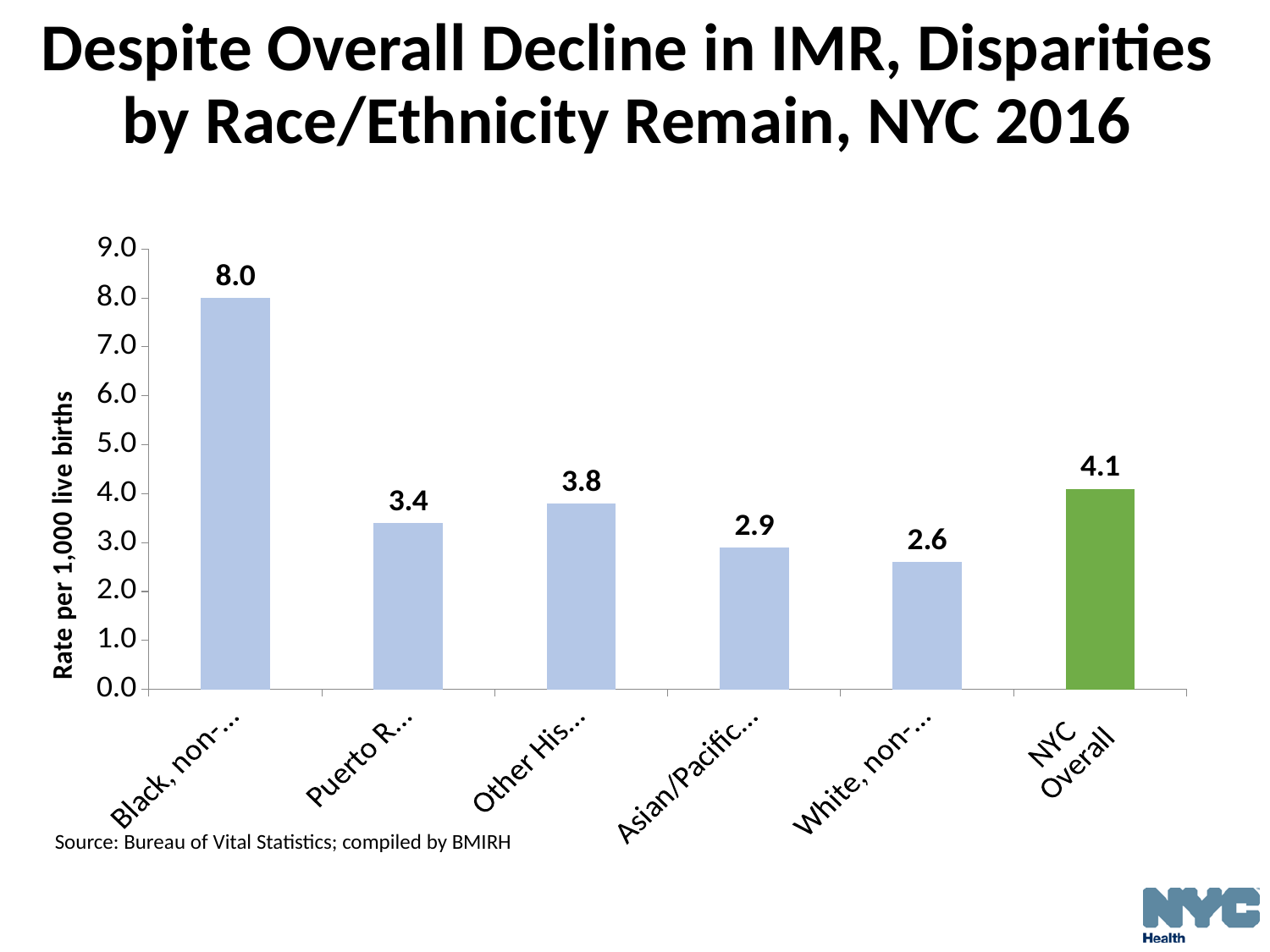
What is the value of the bar labelled "White, non-…"? 2.6 What is the value of the bar labelled "Asian/Pacific…"? 2.9 Which is larger, the value for "Puerto R…" or the value for "Other His…"? Other His… Which category has the highest rate? Black, non-… What is the label of the y-axis? Rate per 1,000 live births What type of chart is shown on the slide? Bar chart Which category has the lowest rate? White, non-… What is the value of the first bar, labelled "Black, non-…"? 8.0 What is the difference between the first bar (Black, non-…) and NYC Overall? 3.9 How many bars are shown in the chart? 6 What is the value for NYC Overall? 4.1 Which bar is coloured green rather than blue? NYC Overall